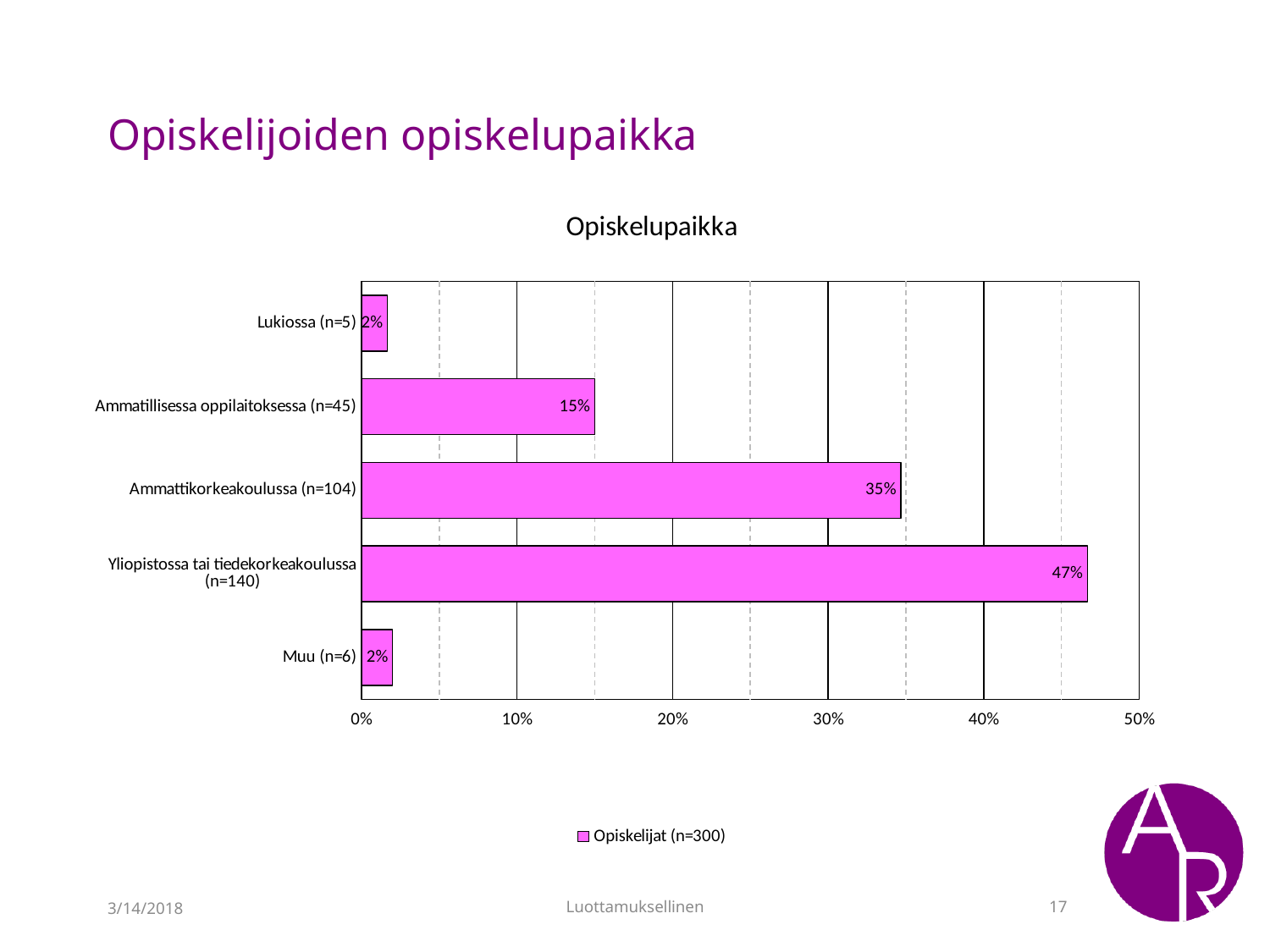
Which is larger, the value for Ammatillisessa oppilaitoksessa (n=45) or Ammattikorkeakoulussa (n=104)? Ammattikorkeakoulussa (n=104) What is the value for Ammattikorkeakoulussa (n=104)? 35% What is the value for Lukiossa (n=5)? 2% What kind of chart is shown on the slide? bar chart What is the title of the chart? Opiskelupaikka What is the value for Ammatillisessa oppilaitoksessa (n=45)? 15% Which category has the highest value? Yliopistossa tai tiedekorkeakoulussa (n=140) How many series does the legend list? 1 Is the value for Yliopistossa tai tiedekorkeakoulussa (n=140) greater or less than 40%? greater What is the difference between the values for Yliopistossa tai tiedekorkeakoulussa (n=140) and Ammattikorkeakoulussa (n=104)? 12% How many categories are shown in the chart? 5 What is the value for Yliopistossa tai tiedekorkeakoulussa (n=140)? 47%